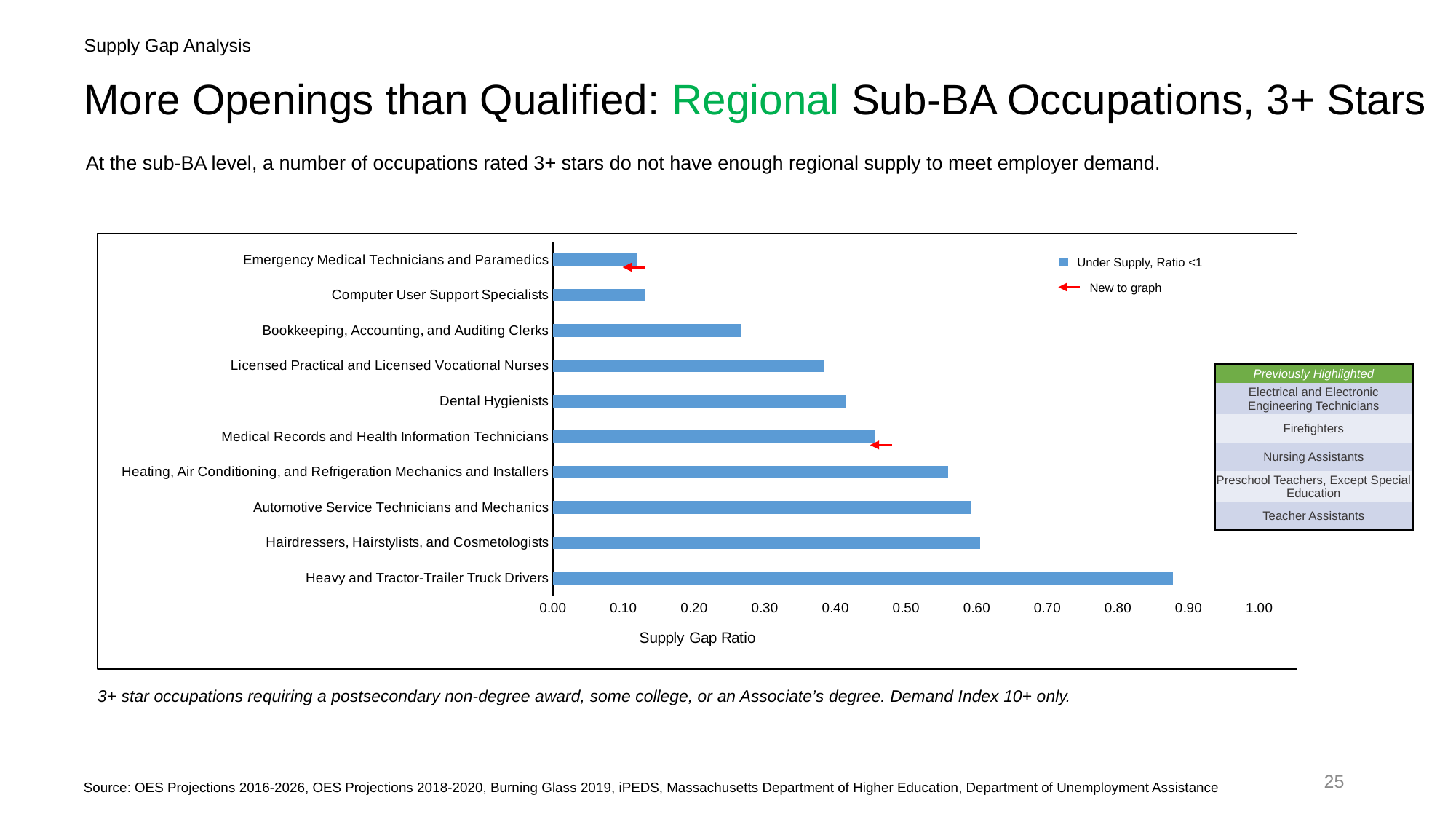
Which occupation has the highest Supply Gap Ratio? Heavy and Tractor-Trailer Truck Drivers Is the Supply Gap Ratio for Emergency Medical Technicians and Paramedics greater or less than 0.20? less Which has a larger Supply Gap Ratio: Bookkeeping, Accounting, and Auditing Clerks or Licensed Practical and Licensed Vocational Nurses? Licensed Practical and Licensed Vocational Nurses Is the Supply Gap Ratio for Heating, Air Conditioning, and Refrigeration Mechanics and Installers greater or less than 0.50? greater What is the title of the horizontal axis of the chart? Supply Gap Ratio Is the Supply Gap Ratio for Medical Records and Health Information Technicians greater or less than 0.50? less How many occupations are plotted in the chart? 10 Which has a larger Supply Gap Ratio: Hairdressers, Hairstylists, and Cosmetologists or Heavy and Tractor-Trailer Truck Drivers? Heavy and Tractor-Trailer Truck Drivers Which occupations are marked with a red arrow as new to the graph? Emergency Medical Technicians and Paramedics; Medical Records and Health Information Technicians What kind of chart is shown on the slide? bar chart